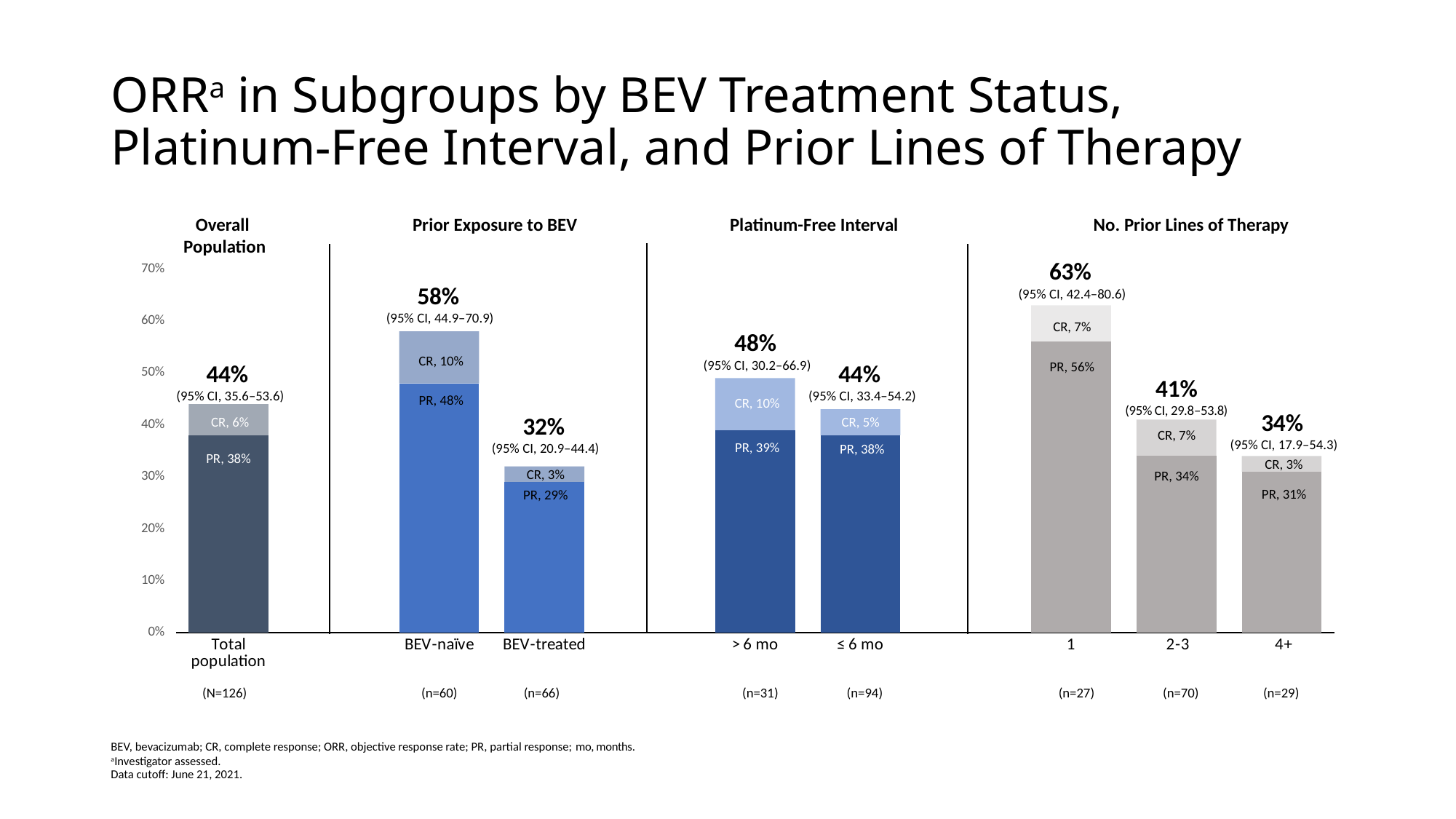
What is the 95% CI shown for the ORR of the 4+ prior lines subgroup? 17.9–54.3 Which subgroup bar has the lowest ORR? BEV-treated (32%) What is the sample size (n) for the ≤ 6 mo platinum-free interval subgroup? n=94 What is the ORR for the BEV-naïve subgroup? 58% Which has a higher ORR, the > 6 mo or the ≤ 6 mo platinum-free interval subgroup? > 6 mo What is the CR rate for patients with 1 prior line of therapy? 7% What kind of chart is shown on the slide? Stacked bar chart What is the difference in ORR between the BEV-naïve and BEV-treated subgroups? 26 percentage points Which subgroup bar has the highest ORR? 1 prior line of therapy (63%) What is the PR rate shown for the total population bar? 38% How many bars are plotted on the chart? 8 Across the No. Prior Lines of Therapy group, does ORR rise or fall from 1 to 4+ prior lines? Fall